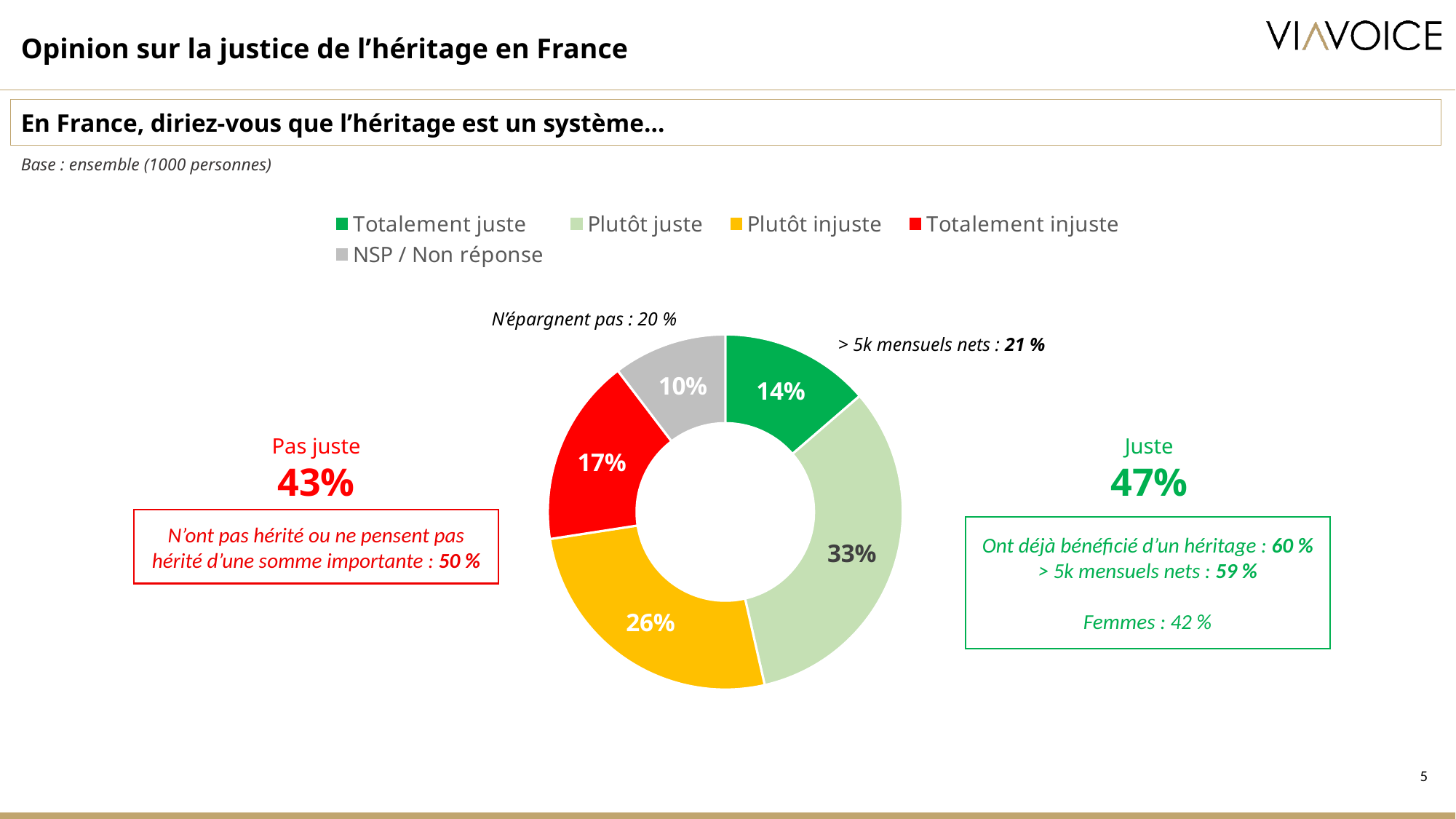
Which is larger: the share for "Totalement juste" or the share for "Totalement injuste"? Totalement injuste How many categories does the legend list? 5 What percentage of respondents answered "Plutôt juste"? 33% What colour represents "Plutôt injuste" in the chart? Yellow/orange What percentage of respondents answered "Totalement injuste"? 17% Which response category has the largest share of the chart? Plutôt juste What is the combined total of "Totalement juste" and "Plutôt juste" as shown on the slide? 47% What is the difference in percentage points between "Plutôt juste" and "Plutôt injuste"? 7 What kind of chart is shown on the slide? Pie chart (donut) Which response category has the smallest share of the chart? NSP / Non réponse What is the value shown for "NSP / Non réponse"? 10% What is the value shown for "Plutôt injuste"? 26%